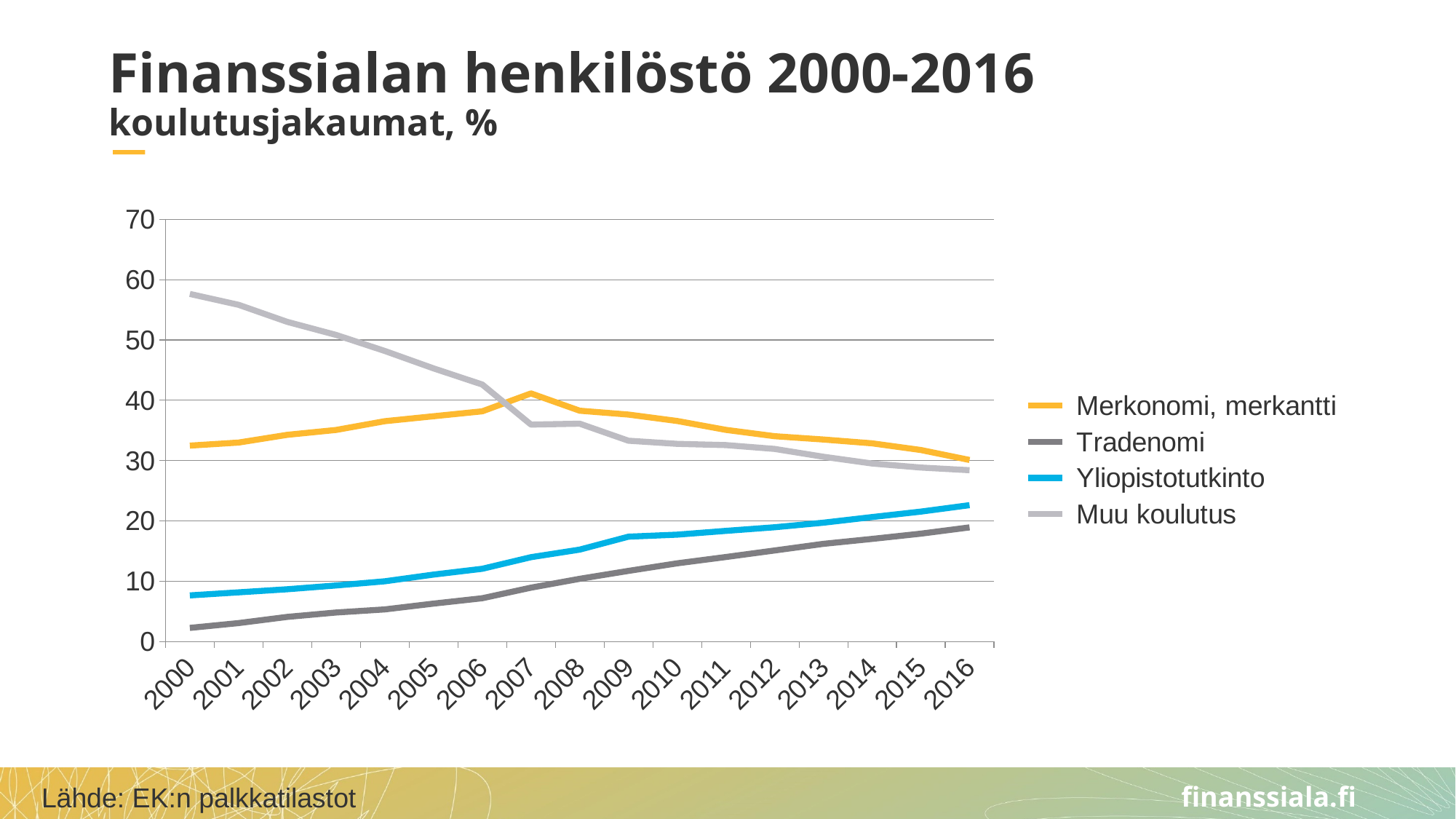
What kind of chart is shown on the slide? line chart Which series has the lowest value in 2000? Tradenomi How many series does the legend list? 4 Which series has the highest value in 2010? Merkonomi, merkantti Does the Tradenomi line rise or fall from 2000 to 2016? rise In 2000, which is higher: Merkonomi, merkantti or Muu koulutus? Muu koulutus Does the Muu koulutus line rise or fall from 2000 to 2016? fall Is the value for Muu koulutus in 2000 greater or less than 50? greater Is the value for Yliopistotutkinto in 2016 greater or less than 20? greater What is the title of the chart slide? Finanssialan henkilöstö 2000-2016 Is the value for Tradenomi in 2000 greater or less than 10? less How many years are shown on the x axis? 17